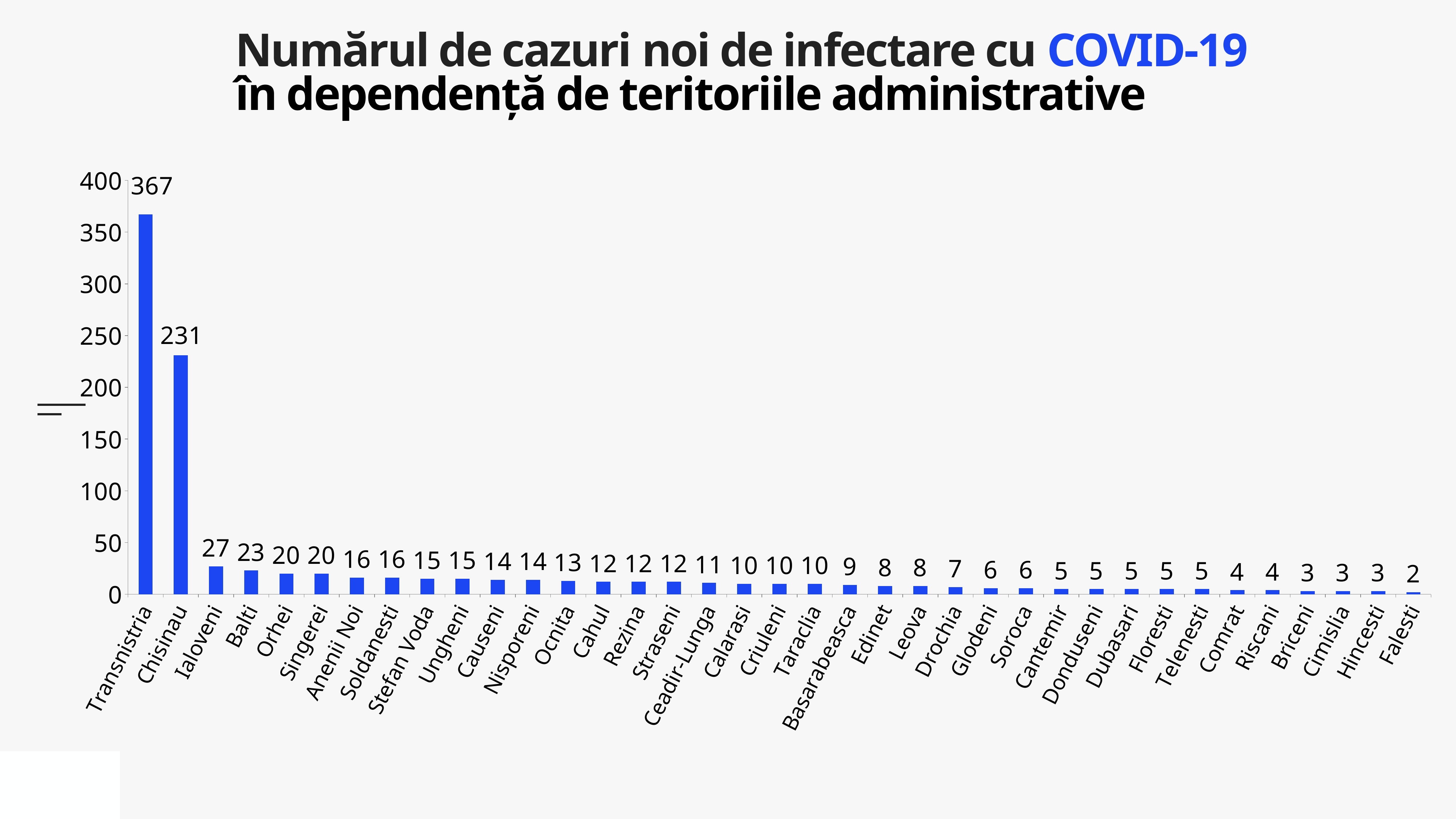
What is the value for Chisinau? 231 What kind of chart is shown on the slide? Bar chart Which territory has the lowest number of new cases? Falesti What is the value for Transnistria? 367 What is the value for Ialoveni? 27 What is the value for Falesti? 2 Which territory has the highest number of new cases? Transnistria Which has a larger value, Balti or Orhei? Balti What is the difference between the values for Transnistria and Chisinau? 136 What is the value for Ocnita? 13 Is the value for Chisinau greater or less than 200? greater How many territories are shown on the x axis? 37